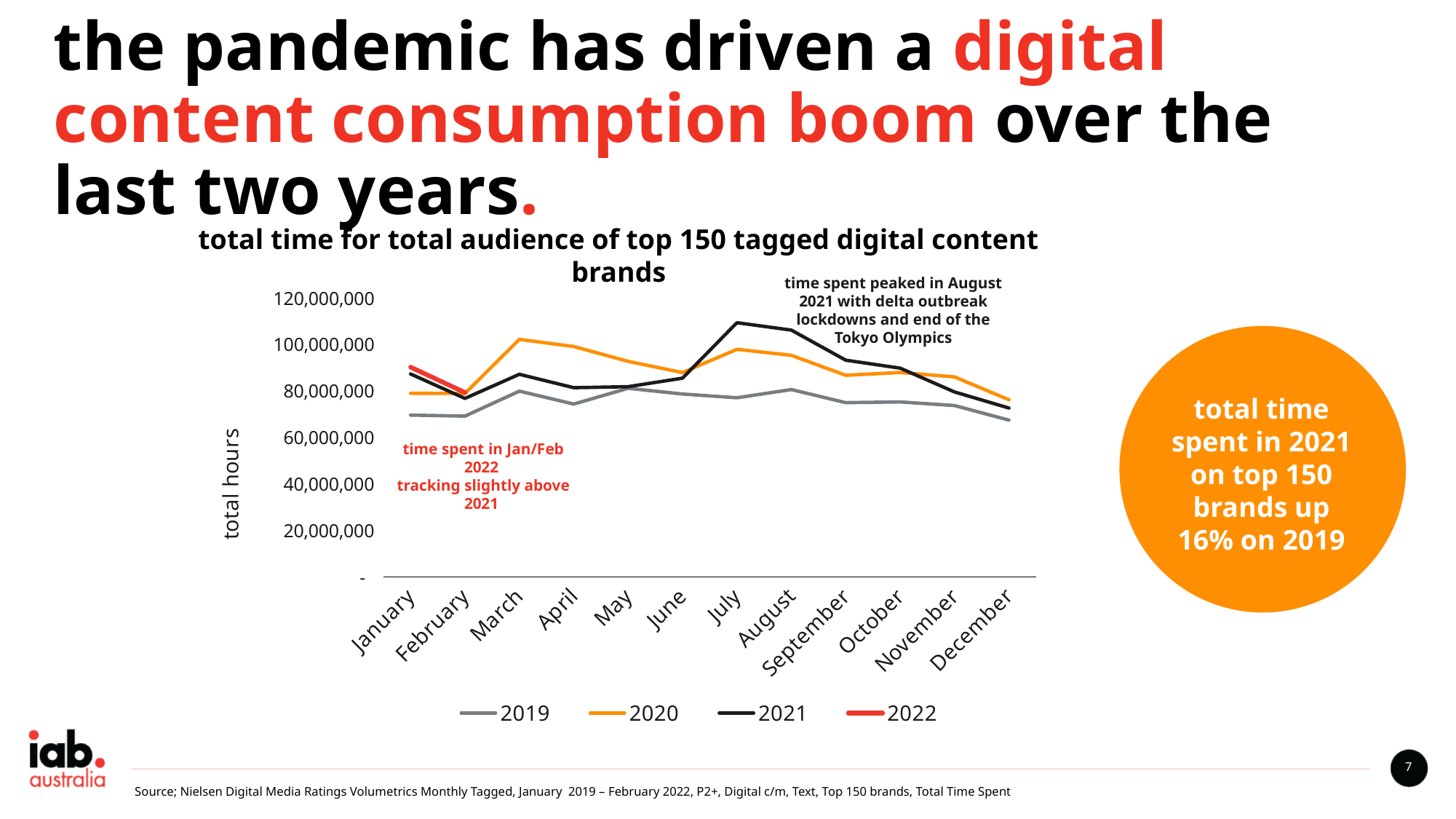
How many months are shown along the x axis? 12 Is the value for 2019 in January greater or less than 80,000,000? less What type of chart is shown on the slide? line chart Does the 2021 line rise or fall from August to December? fall Is the value for 2022 in January greater or less than 80,000,000? greater Which is larger in January: the value for 2022 or the value for 2020? 2022 Which is larger in August: the value for 2021 or the value for 2019? 2021 In which month does the 2021 line reach its highest value? July Is the value for 2021 in August greater or less than 100,000,000? greater What is the label on the y axis? total hours Which series are listed in the legend? 2019, 2020, 2021, 2022 How many series does the legend list? 4